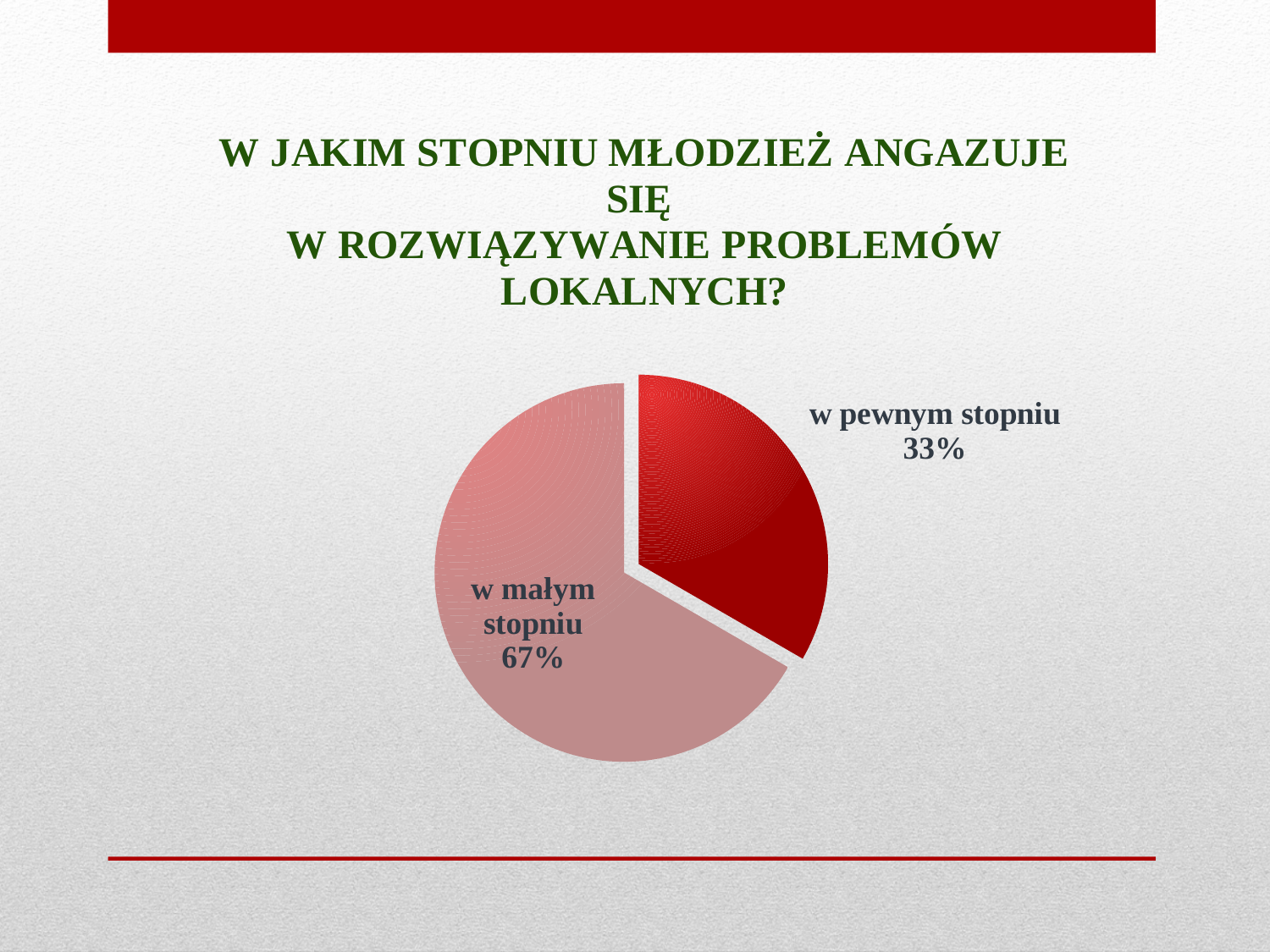
Which is larger: "w pewnym stopniu" or "w małym stopniu"? w małym stopniu Which slice of the pie is the largest? w małym stopniu What share of the pie does "w pewnym stopniu" have? 33% What is the difference in percentage points between "w małym stopniu" and "w pewnym stopniu"? 34 What share of the pie does "w małym stopniu" have? 67% What kind of chart is shown on the slide? pie chart Which slice of the pie is the smallest? w pewnym stopniu Which slice is pulled out (exploded) from the pie? w pewnym stopniu How many slices does the pie chart have? 2 What is the title of the slide above the chart? W JAKIM STOPNIU MŁODZIEŻ ANGAZUJE SIĘ W ROZWIĄZYWANIE PROBLEMÓW LOKALNYCH?